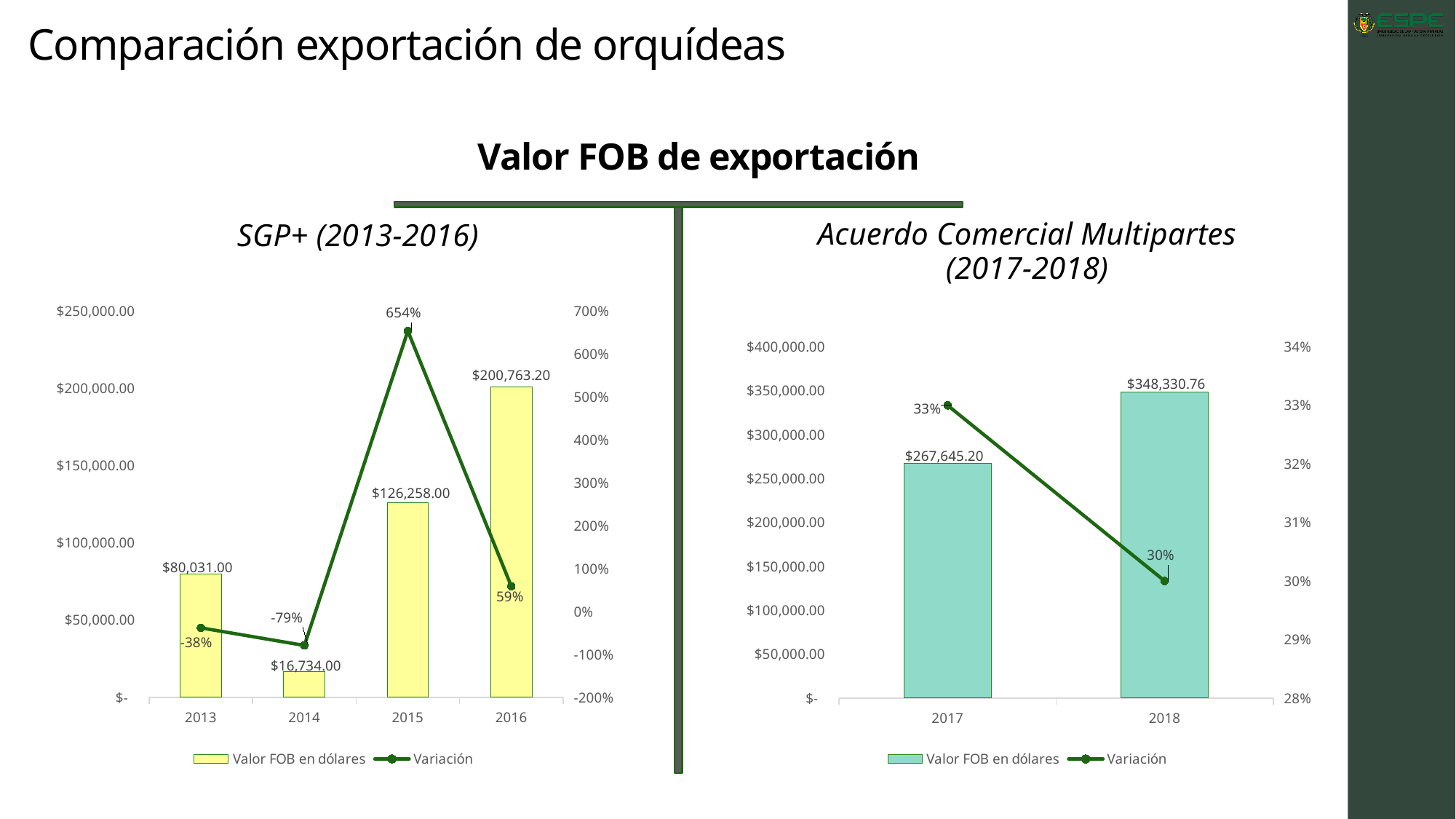
In the SGP+ (2013-2016) chart, how many years are shown on the x axis? 4 In the SGP+ (2013-2016) chart, which year has the lowest Valor FOB en dólares? 2014 In the SGP+ (2013-2016) chart, which year has the highest Variación? 2015 In the Acuerdo Comercial Multipartes (2017-2018) chart, which year has the larger Valor FOB en dólares, 2017 or 2018? 2018 In the Acuerdo Comercial Multipartes (2017-2018) chart, what is the Variación value for 2017? 33% In the SGP+ (2013-2016) chart, what is the Valor FOB en dólares for 2015? $126,258.00 How many series does the legend of the Acuerdo Comercial Multipartes (2017-2018) chart list? 2 What is the overall title shown above the two charts? Valor FOB de exportación In the SGP+ (2013-2016) chart, what is the Variación value for 2014? -79% In the SGP+ (2013-2016) chart, what is the difference in Valor FOB en dólares between 2016 and 2013? $120,732.20 In the Acuerdo Comercial Multipartes (2017-2018) chart, does the Variación line rise or fall from 2017 to 2018? fall In the Acuerdo Comercial Multipartes (2017-2018) chart, what is the Valor FOB en dólares for 2018? $348,330.76